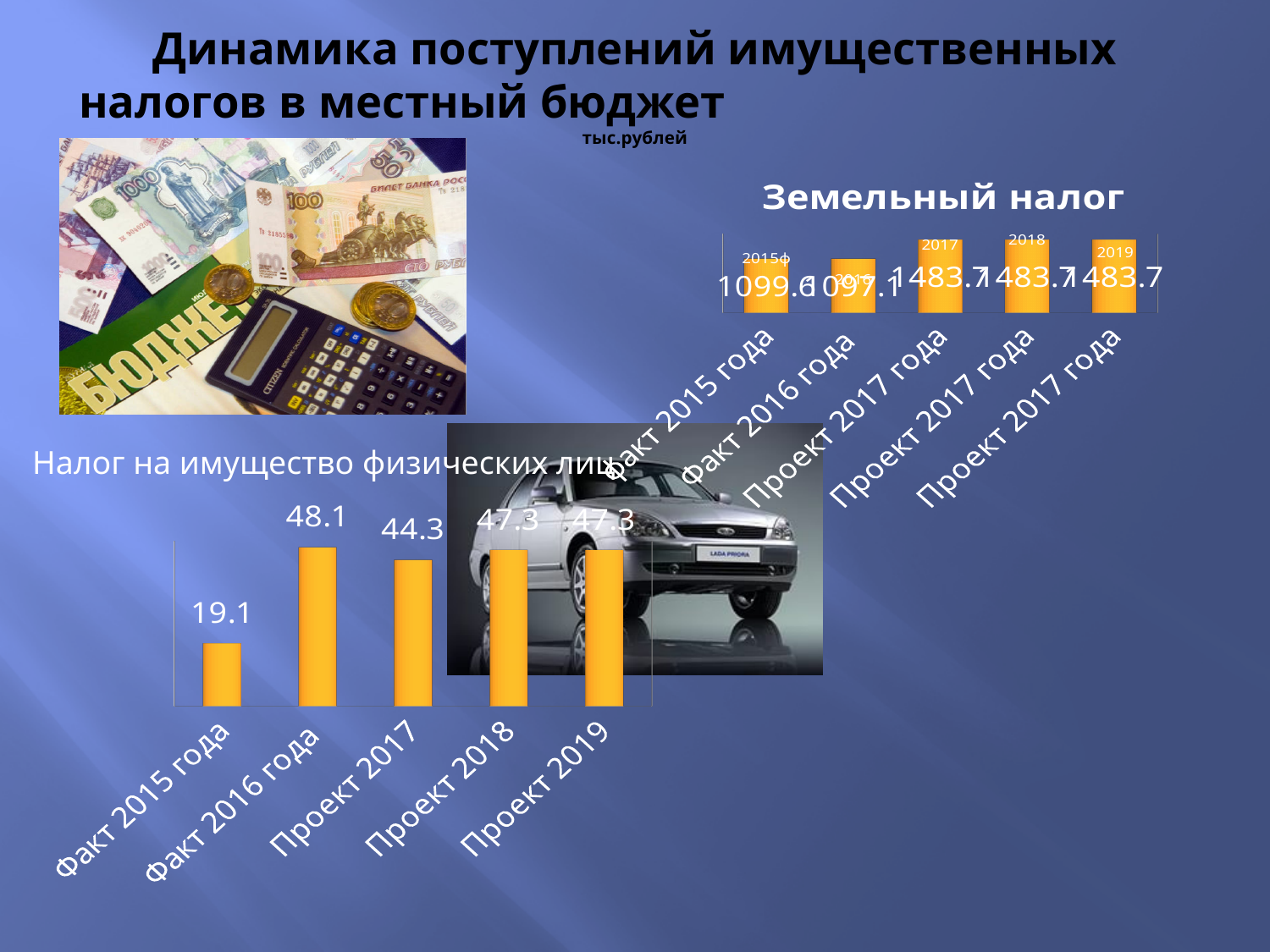
In the 'Налог на имущество физических лиц' chart, what is the value for Проект 2017? 44.3 In the 'Земельный налог' chart, what is the value for Факт 2015 года? 1099.6 In the 'Налог на имущество физических лиц' chart, which category has the lowest value? Факт 2015 года In the 'Налог на имущество физических лиц' chart, what is the value for Факт 2016 года? 48.1 How many bars are in the 'Налог на имущество физических лиц' chart? 5 In the 'Налог на имущество физических лиц' chart, what is the value for Факт 2015 года? 19.1 What type of chart is the 'Земельный налог' chart? bar chart In the 'Земельный налог' chart, what is the value of the third bar (marked 2017)? 1483.7 In the 'Налог на имущество физических лиц' chart, which is larger: Проект 2017 or Проект 2018? Проект 2018 In the 'Налог на имущество физических лиц' chart, what is the difference between Факт 2016 года and Факт 2015 года? 29.0 In the 'Налог на имущество физических лиц' chart, which category has the highest value? Факт 2016 года What unit is stated under the slide title for the charts? тыс.рублей